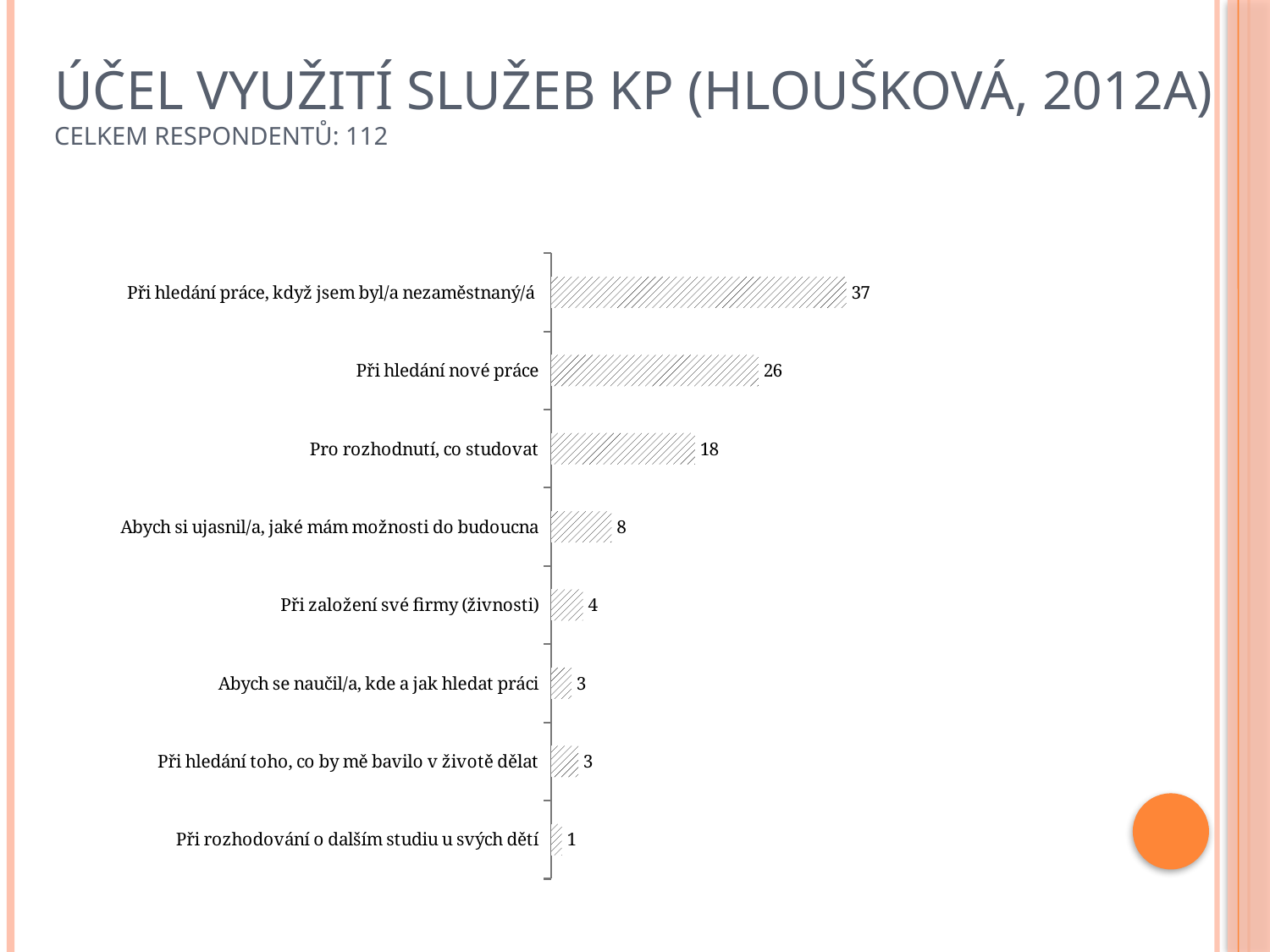
Which category has the highest value? Při hledání práce, když jsem byl/a nezaměstnaný/á What is the total number of respondents stated on the slide? 112 What is the value for "Abych se naučil/a, kde a jak hledat práci"? 3 How many categories are shown in the chart? 8 Which is larger: the value for "Při hledání nové práce" or the value for "Pro rozhodnutí, co studovat"? Při hledání nové práce What is the value for "Pro rozhodnutí, co studovat"? 18 What is the value for "Při hledání práce, když jsem byl/a nezaměstnaný/á"? 37 What is the difference between the values for "Pro rozhodnutí, co studovat" and "Abych si ujasnil/a, jaké mám možnosti do budoucna"? 10 What is the difference between the values for "Při hledání práce, když jsem byl/a nezaměstnaný/á" and "Při hledání nové práce"? 11 What is the value for "Při založení své firmy (živnosti)"? 4 What kind of chart is shown on the slide? Bar chart Which category has the lowest value? Při rozhodování o dalším studiu u svých dětí